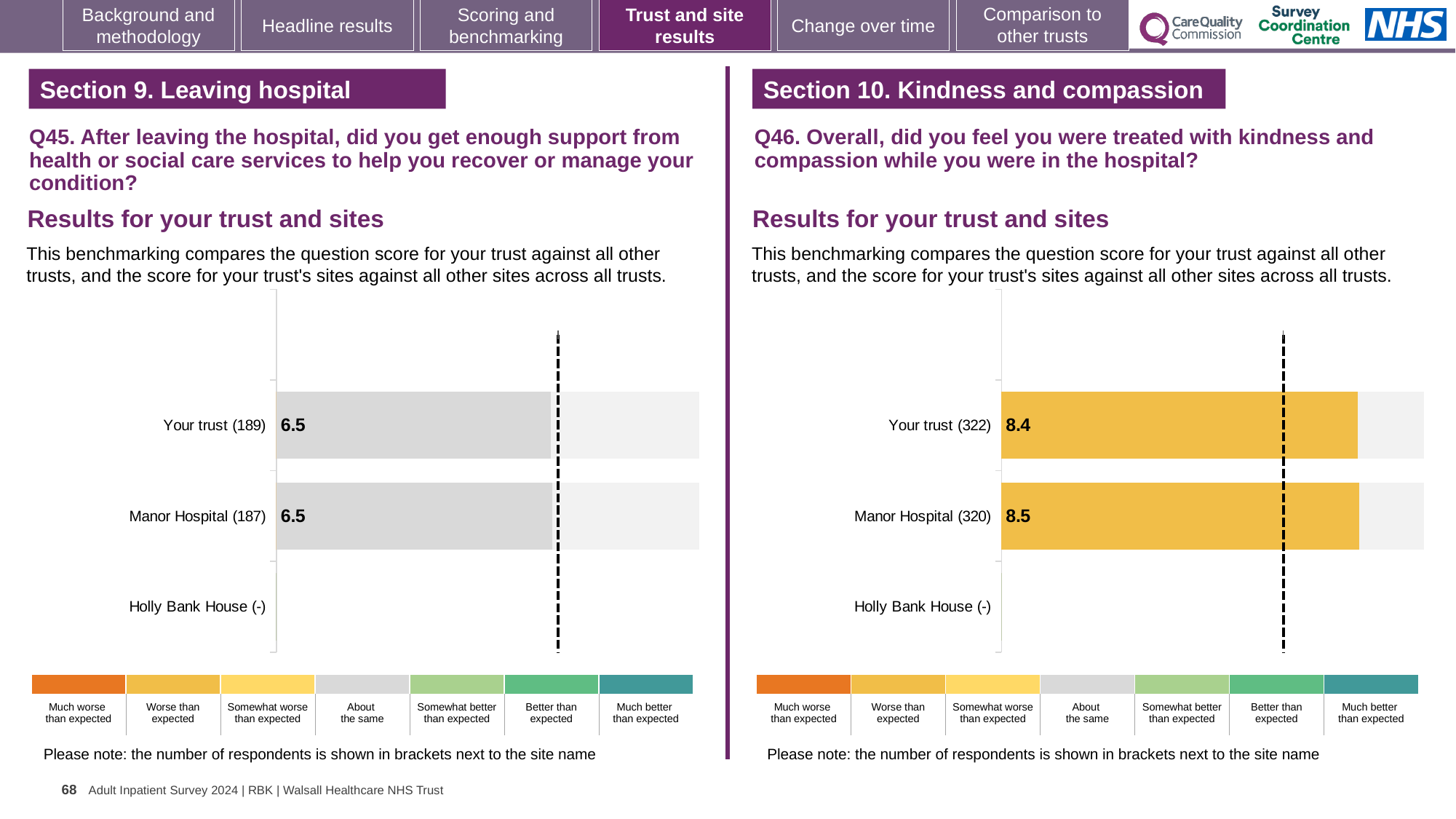
In the Q46 chart on the right, what is the score for Manor Hospital? 8.5 In the Q46 chart on the right, how many respondents are shown in brackets for Manor Hospital? 320 In the Q45 chart on the left, what is the score for Manor Hospital? 6.5 How many site/trust categories are listed on the y axis of the Q45 chart on the left? 3 In the Q45 chart on the left, what is the score for Your trust? 6.5 In the Q46 chart on the right, what is the score for Your trust? 8.4 In the Q46 chart on the right, which has the higher score, Your trust or Manor Hospital? Manor Hospital In the Q45 chart on the left, how many respondents are shown in brackets for Your trust? 189 What kind of chart is used for the Q46 results on the right? Bar chart In the Q46 chart on the right, which benchmark category does the colour of the Your trust bar correspond to? Worse than expected In the Q46 chart on the right, what is the difference between the Manor Hospital score and the Your trust score? 0.1 In the Q45 chart on the left, what is the difference between the Your trust score and the Manor Hospital score? 0